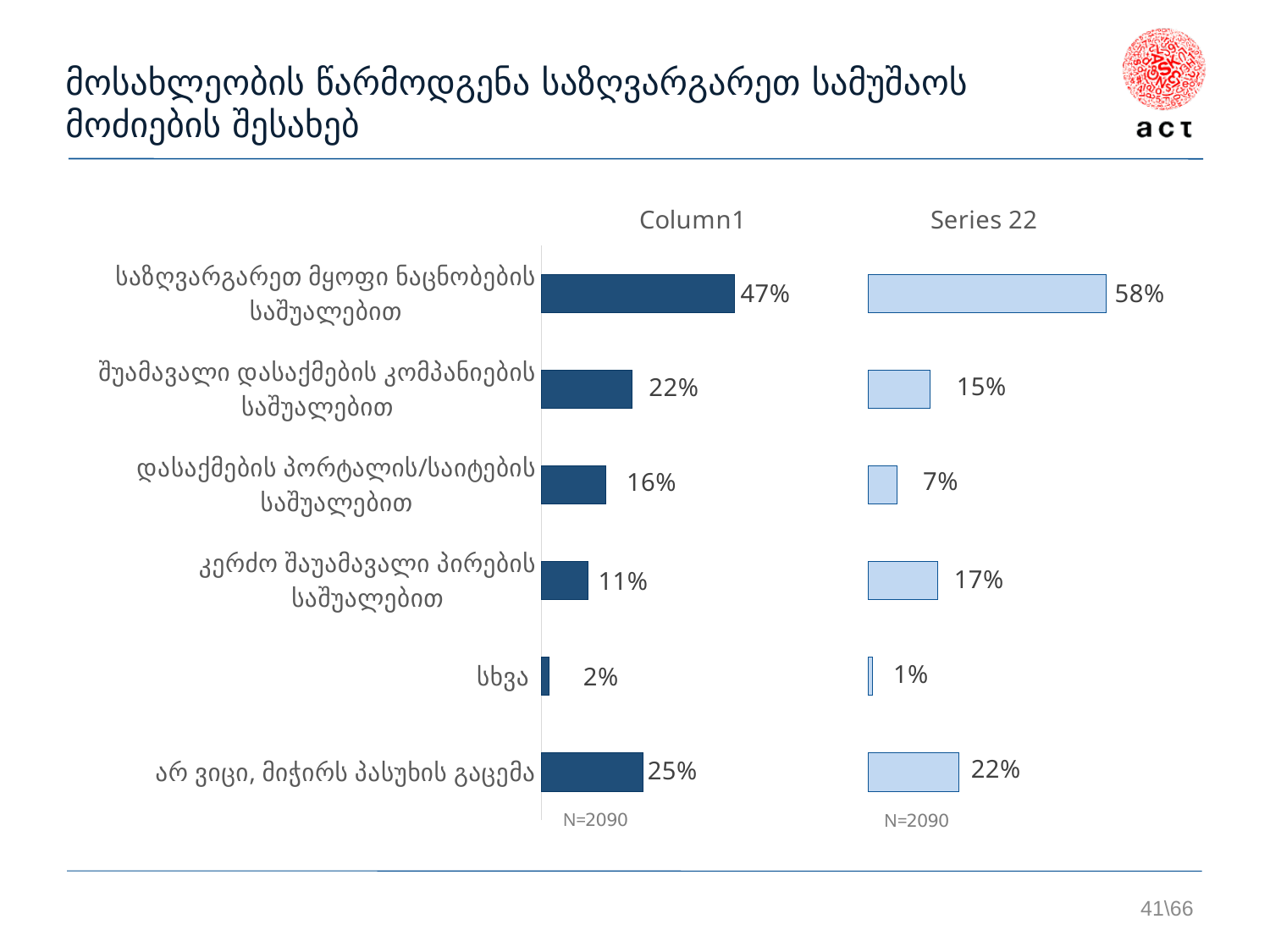
In the "Series 22" chart, which category has the lowest value? სხვა In the "Column1" chart, which is larger: "არ ვიცი, მიჭირს პასუხის გაცემა" or "შუამავალი დასაქმების კომპანიების საშუალებით"? არ ვიცი, მიჭირს პასუხის გაცემა What sample size (N) is shown beneath the "Column1" chart? N=2090 In the "Column1" chart, what is the value for "საზღვარგარეთ მყოფი ნაცნობების საშუალებით"? 47% How many categories are shown in the "Column1" chart? 6 In the "Series 22" chart, what is the value for "დასაქმების პორტალის/საიტების საშუალებით"? 7% What is the difference between the "Series 22" value and the "Column1" value for "საზღვარგარეთ მყოფი ნაცნობების საშუალებით"? 11% For "კერძო შუამავალი პირების საშუალებით", which chart shows the larger value, "Column1" or "Series 22"? Series 22 In the "Column1" chart, what is the difference between "შუამავალი დასაქმების კომპანიების საშუალებით" and "კერძო შუამავალი პირების საშუალებით"? 11% In the "Series 22" chart, what is the value for "არ ვიცი, მიჭირს პასუხის გაცემა"? 22% What type of chart is the "Series 22" chart? Bar chart In the "Column1" chart, which category has the highest value? საზღვარგარეთ მყოფი ნაცნობების საშუალებით